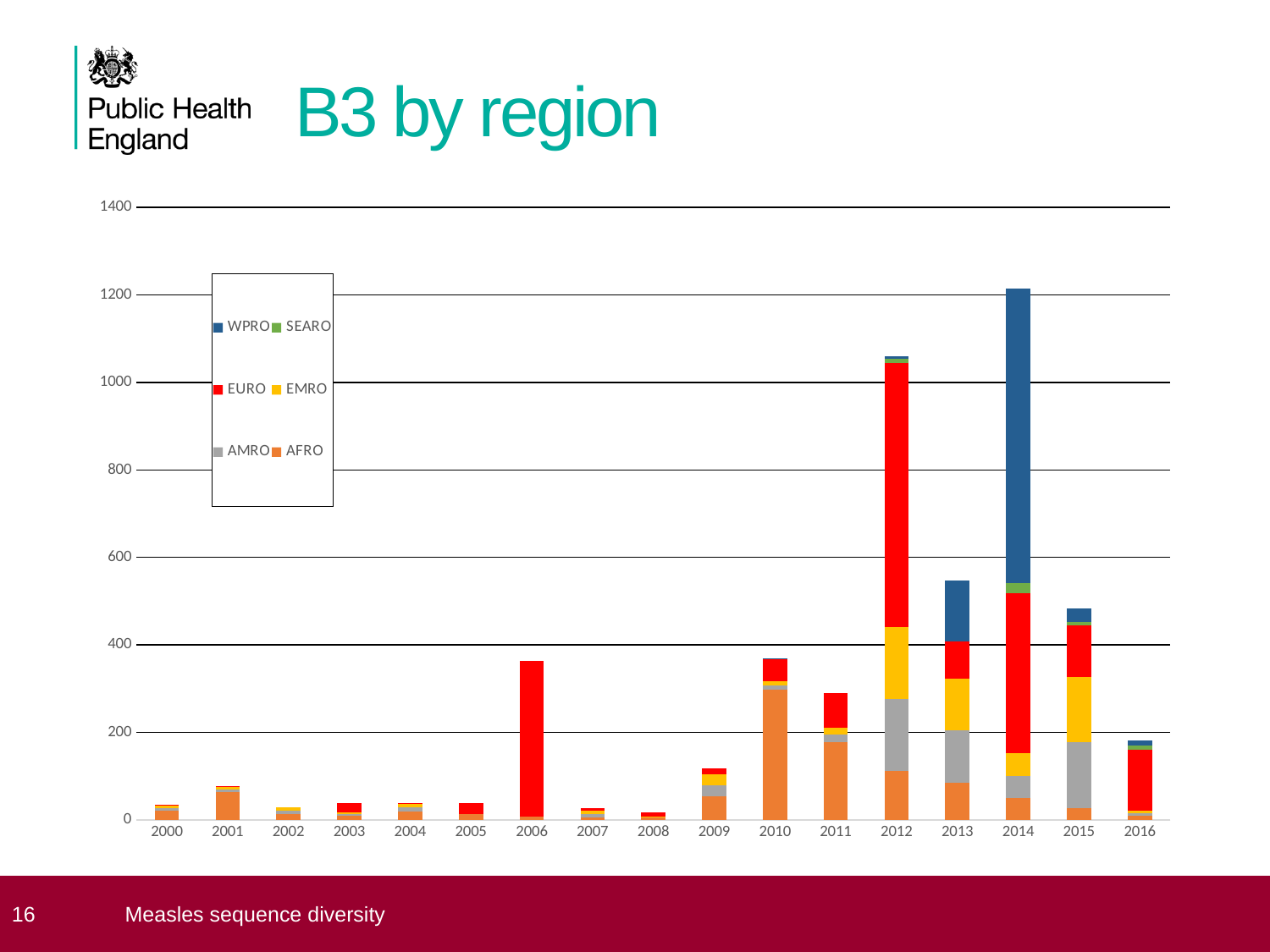
Is the total for 2015 greater or less than 400? greater Which region accounts for most of the 2014 bar? WPRO Is the total for 2006 greater or less than 400? less Is the total for 2013 greater or less than 600? less How many years are shown along the x axis? 17 Which year has the lowest total bar? 2008 Which year has the highest total bar? 2014 Which region accounts for almost all of the 2006 bar? EURO What kind of chart is shown on the slide? Stacked bar chart Which year has the larger total bar, 2012 or 2013? 2012 How many series does the legend list? 6